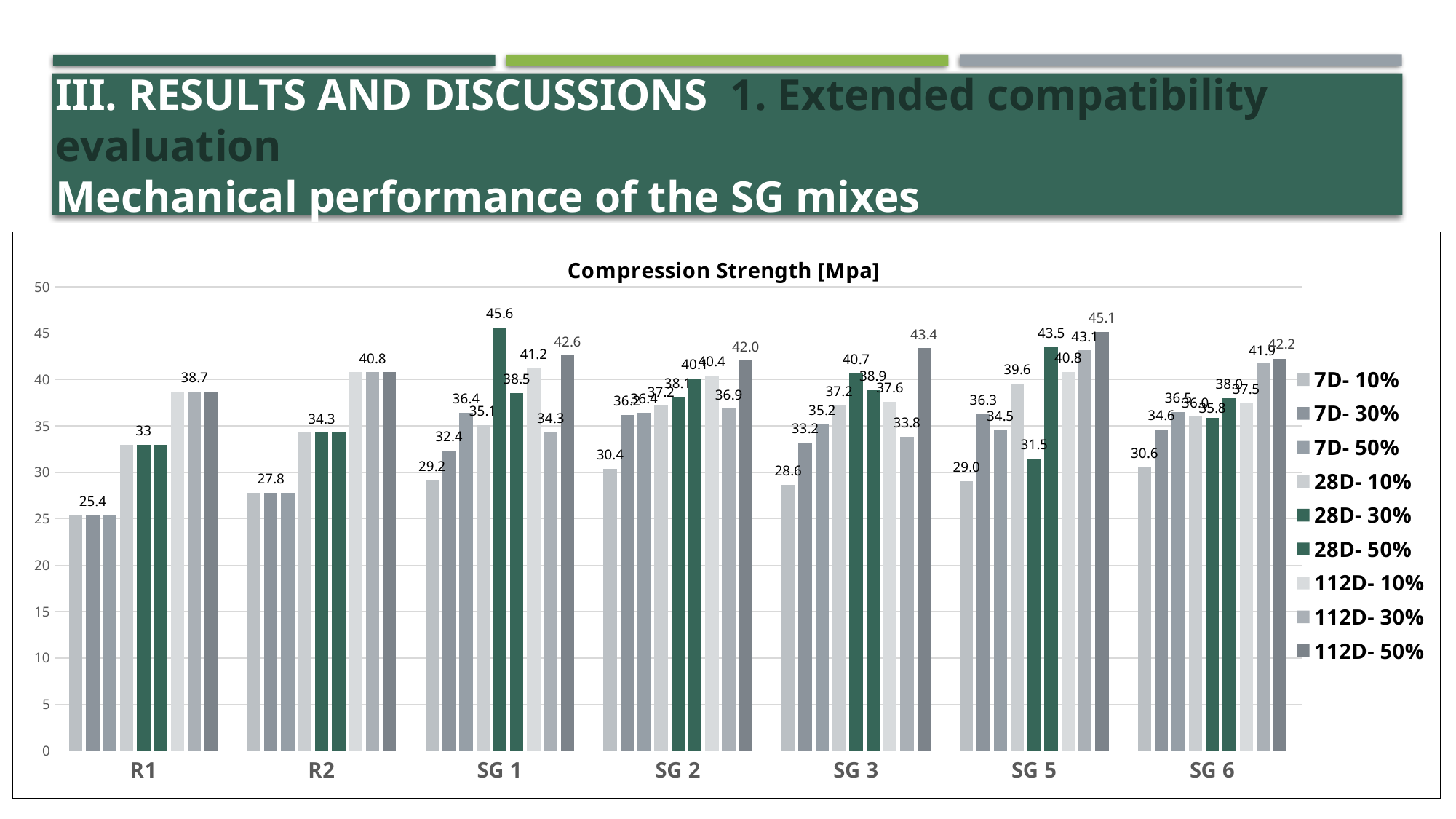
Is the 7D- 10% value for R2 greater or less than 30? less What type of chart is shown on the slide? bar chart How many mix categories are shown on the x axis? 7 What is the 112D- 50% compression strength for SG 5? 45.1 Which is larger, the 28D- 50% value for SG 5 or the 28D- 50% value for SG 1? SG 5 Which mix has the highest 112D- 50% compression strength? SG 5 What is the 7D- 10% compression strength for SG 1? 29.2 How many series does the legend list? 9 What is the difference between the 112D- 50% values for SG 5 and SG 3? 1.7 What is the 28D- 30% compression strength for SG 1? 45.6 What is the title of the chart? Compression Strength [Mpa] Which mix has the lowest 7D- 10% compression strength? R1